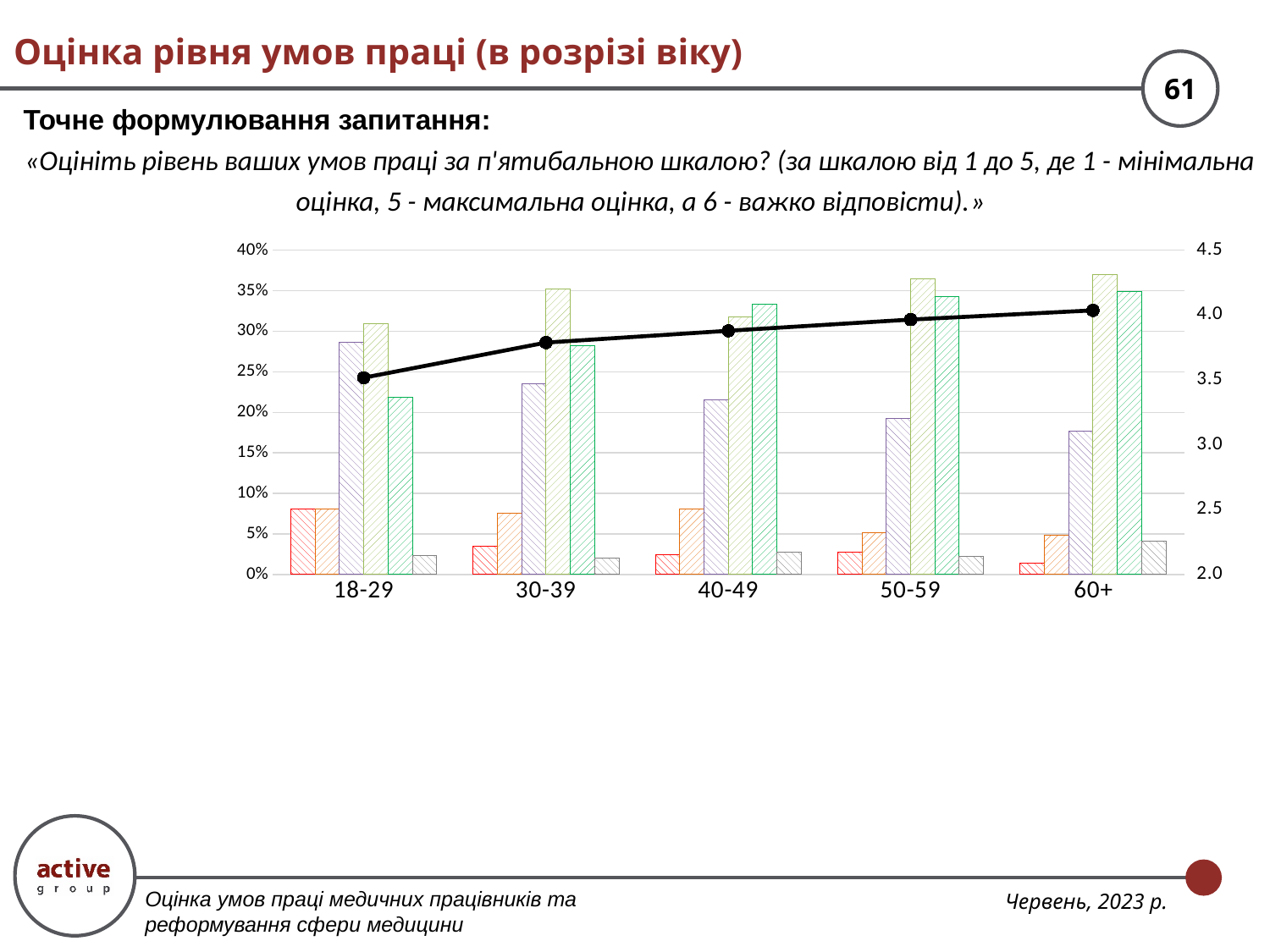
What is the maximum value shown on the left (percentage) axis of the chart? 40% Is the line value for the 18-29 group greater or less than 4.0 on the right axis? less Which age groups are listed on the x axis of the chart? 18-29, 30-39, 40-49, 50-59, 60+ For which age group is the line value highest? 60+ Does the line in the chart rise or fall as age increases from 18-29 to 60+? Rises For which age group is the line value lowest? 18-29 Is the line value for the 30-39 group larger or smaller than the line value for the 18-29 group? larger What kind of chart is shown on the slide? A bar chart combined with a line Is the line value for the 30-39 group greater or less than 3.5 on the right axis? greater Is the tallest bar in the 60+ group greater or less than 35%? greater How many age groups are shown on the x axis of the chart? 5